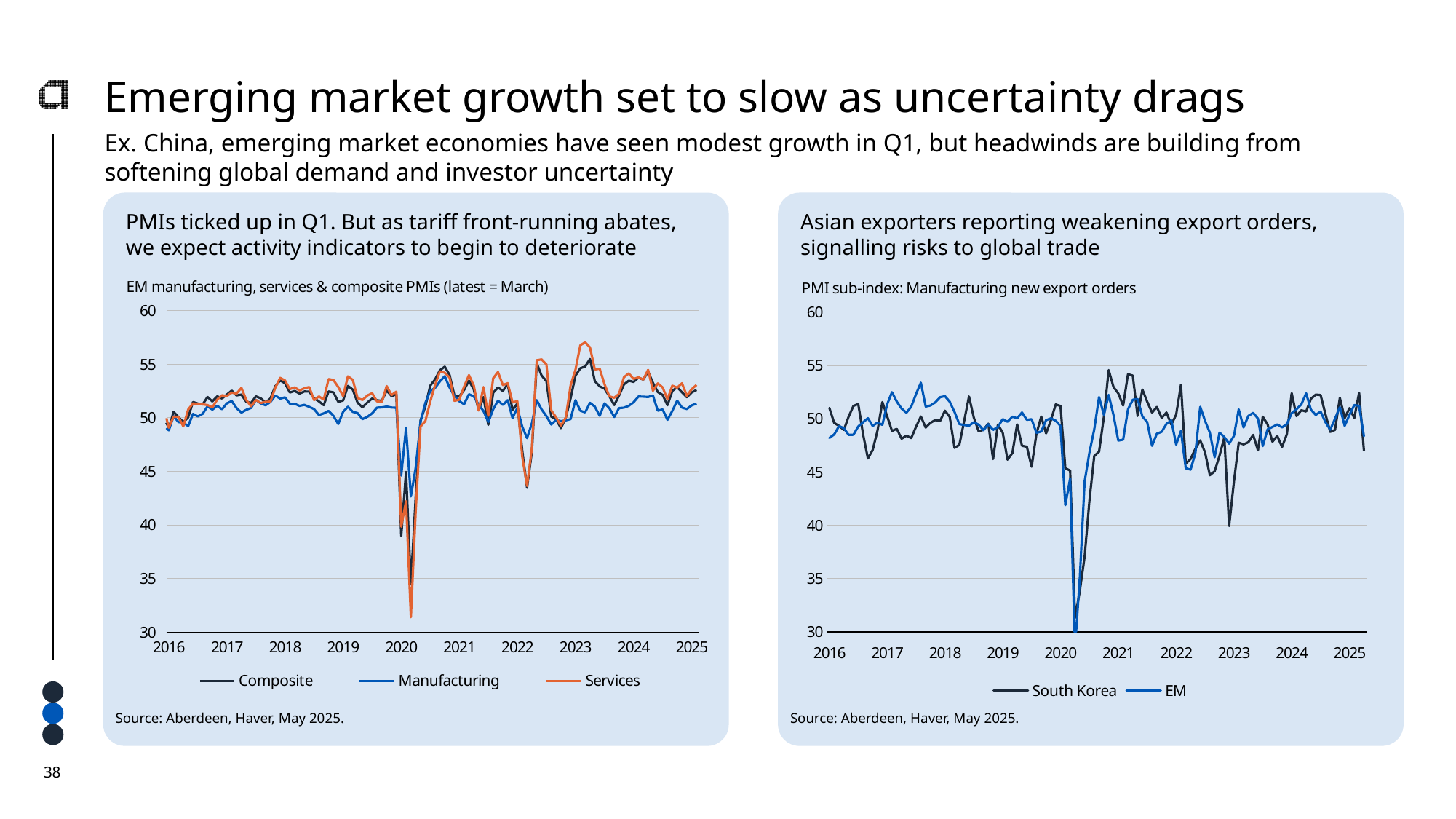
What kind of chart is the left chart, 'EM manufacturing, services & composite PMIs'? line chart What are the names of the series in the legend of the right chart? South Korea, EM What is the source cited below the left chart? Aberdeen, Haver, May 2025. In the right chart, is the lowest value of the EM series in 2020 greater or less than 35? less How many year labels are shown on the x axis of the right chart? 10 In the left chart, which series falls to the lowest value during 2020? Services What kind of chart is the right chart, 'PMI sub-index: Manufacturing new export orders'? line chart In the right chart, which series drops lower during 2020, South Korea or EM? EM In the right chart, is the lowest value of the South Korea series in 2023 greater or less than 45? less How many series does the legend of the left chart list? 3 In the left chart, is the lowest value of the Services series in 2020 greater or less than 35? less How many series does the legend of the right chart list? 2